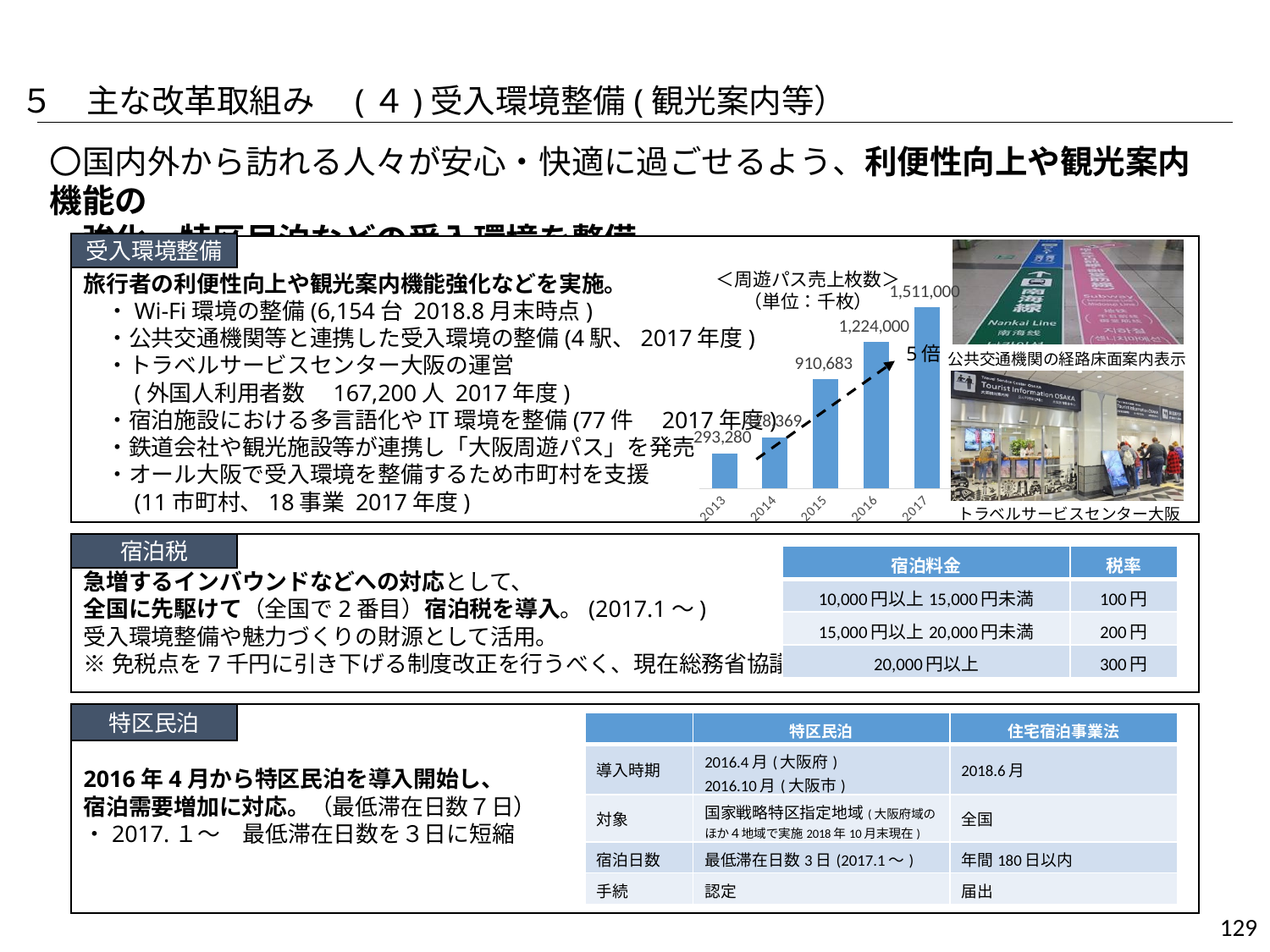
What kind of chart is the 周遊パス売上枚数 chart? bar chart In the 周遊パス売上枚数 chart, what is the value for 2013? 293,280 What unit is stated for the values in the 周遊パス売上枚数 chart? 千枚 In the 周遊パス売上枚数 chart, what is the value for 2017? 1,511,000 How many years are plotted in the 周遊パス売上枚数 chart? 5 In the 周遊パス売上枚数 chart, what is the value for 2015? 910,683 Do the values in the 周遊パス売上枚数 chart rise or fall from 2013 to 2017? rise In the 周遊パス売上枚数 chart, what is the difference between the 2017 and 2016 values? 287,000 Which year has the highest value in the 周遊パス売上枚数 chart? 2017 What is the title of the bar chart on the slide? 周遊パス売上枚数 Which year has the lowest value in the 周遊パス売上枚数 chart? 2013 In the 周遊パス売上枚数 chart, what is the value for 2016? 1,224,000